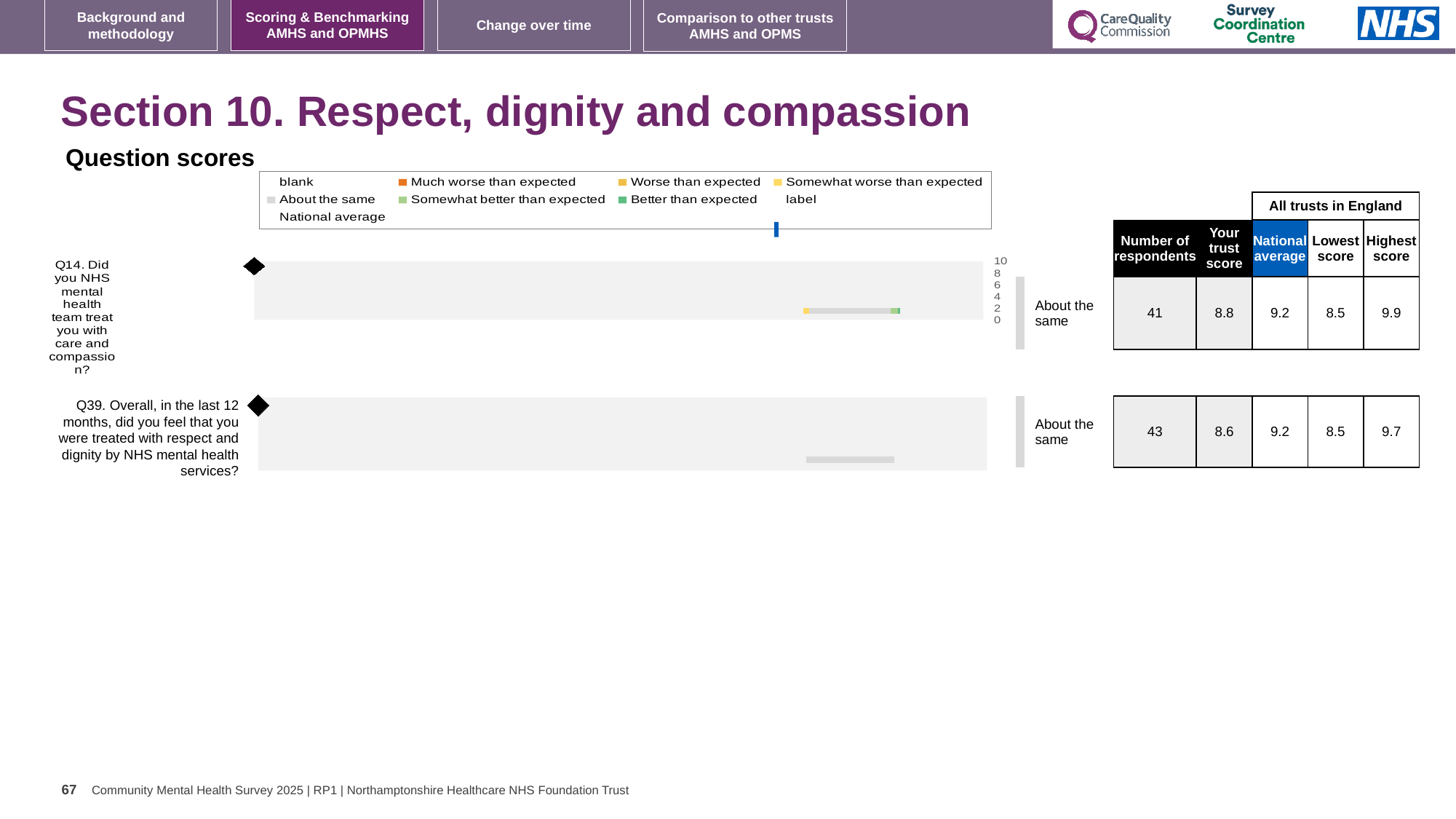
How many respondents are recorded for Q14? 41 Which question has the higher trust score, Q14 or Q39? Q14 What kind of chart is used to show the question scores on this slide? bar chart How many respondents are recorded for Q39? 43 What is the highest score among all trusts in England for Q39? 9.7 What is the national average score for Q39? 9.2 What is the 'Your trust score' for Q39 (respect and dignity)? 8.6 How many questions are plotted in the question scores chart? 2 What is the 'Your trust score' for Q14 (care and compassion)? 8.8 How many more respondents answered Q39 than Q14? 2 What is the difference between the highest score and the lowest score for Q14? 1.4 What benchmark category is shown next to the bar for Q14? About the same